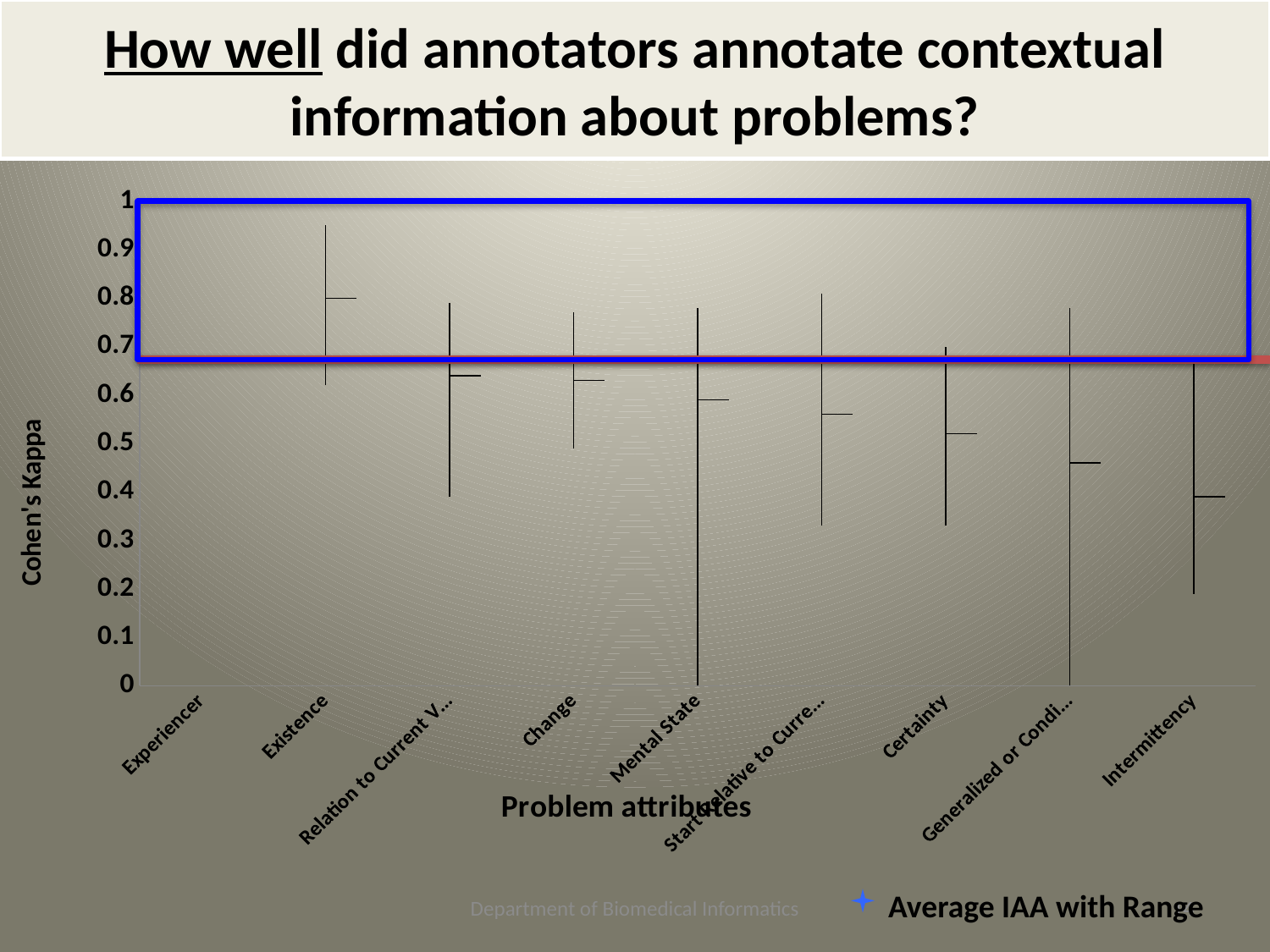
Is the average IAA value for Intermittency greater or less than 0.5? less How many problem attributes are shown along the x axis of the chart? 9 What is the title of the y axis on the chart? Cohen's Kappa Which problem attribute has the lowest average IAA marker on the chart? Intermittency Do the average IAA markers generally rise or fall from left to right across the problem attributes? fall Is the average IAA value for Certainty greater or less than 0.6? less Is the average IAA value for Change greater or less than 0.5? greater What is the title of the x axis on the chart? Problem attributes Which has a higher average IAA marker, Existence or Intermittency? Existence